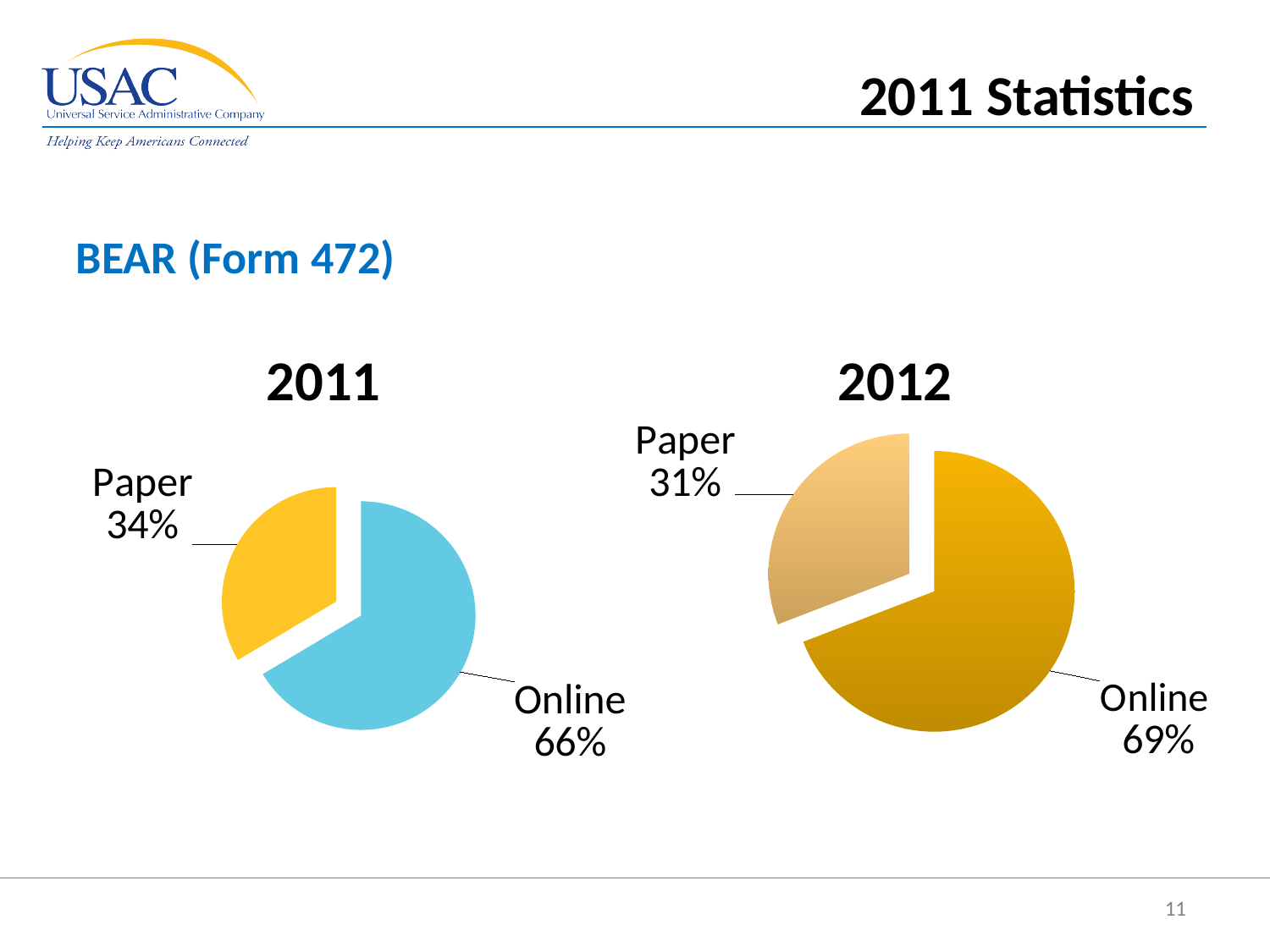
In the 2012 pie chart, which slice is the smallest? Paper What is the title of the chart on the left? 2011 How many slices does the 2012 pie chart have? 2 In the 2012 pie chart, what share is Online? 69% In the 2011 pie chart, what share is Online? 66% In the 2011 pie chart, what is the difference between the Online and Paper shares? 32% What type of chart is the 2011 chart? Pie chart Which is larger: the Online share in the 2011 pie chart or the Online share in the 2012 pie chart? 2012 In the 2011 pie chart, which slice is the largest? Online In the 2012 pie chart, what share is Paper? 31% In the 2012 pie chart, what is the difference between the Online and Paper shares? 38% In the 2011 pie chart, what share is Paper? 34%